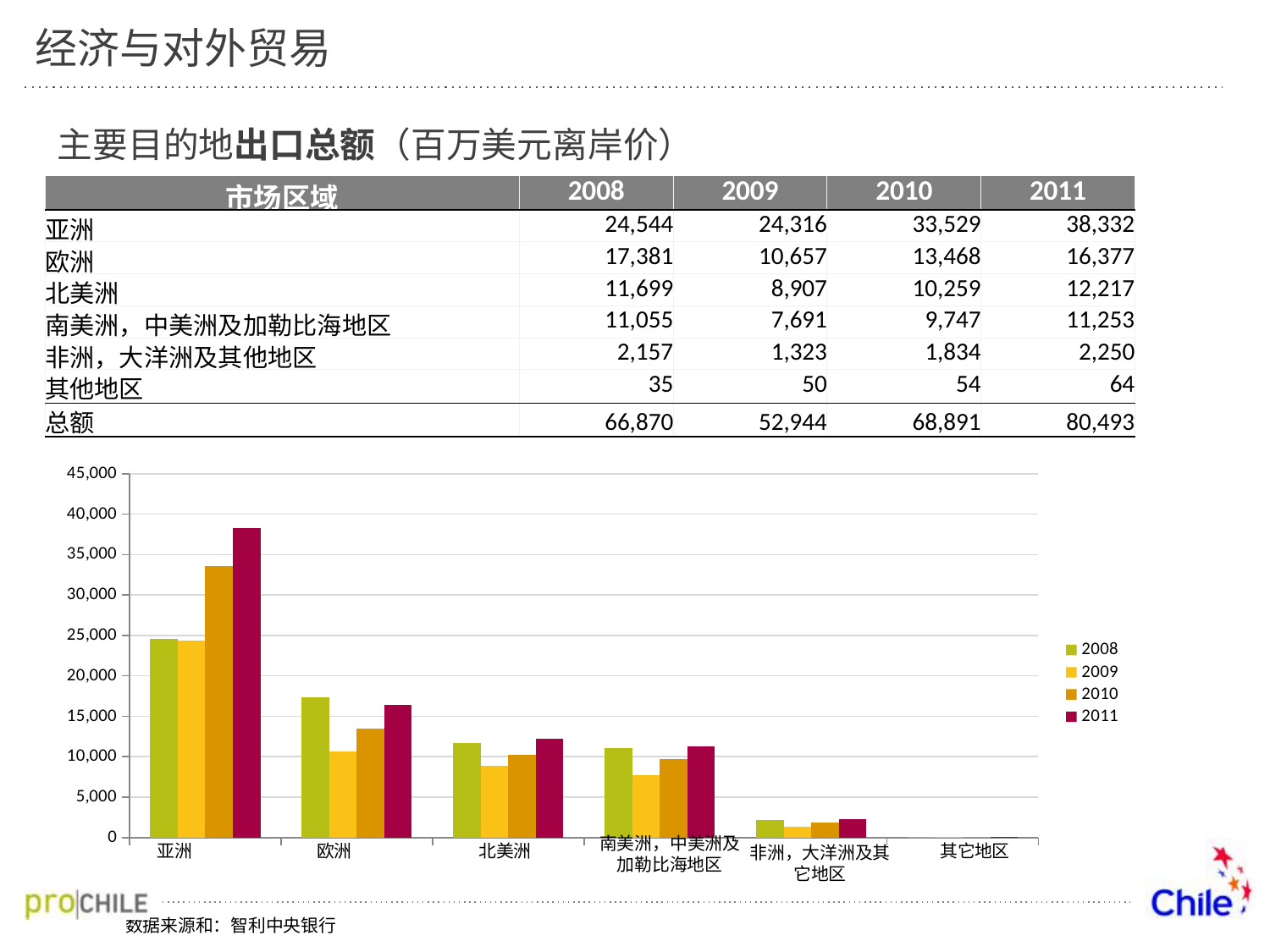
What is the export value for 亚洲 in 2011? 38,332 How many market regions are shown on the x axis of the chart? 6 What is the difference between the 2011 and 2008 export values for 亚洲? 13,788 Which region has the highest export value in 2011? 亚洲 Which is larger for 欧洲: the 2008 value or the 2011 value? 2008 How many series does the chart legend list? 4 What is the export value for 欧洲 in 2009? 10,657 Which legend entry is shown in dark red? 2011 Is the 2009 value for 北美洲 greater or less than 10,000? less What kind of chart is shown on the slide? bar chart Which region has the lowest export value in 2008? 其它地区 Is the 2010 value for 亚洲 greater or less than 30,000? greater